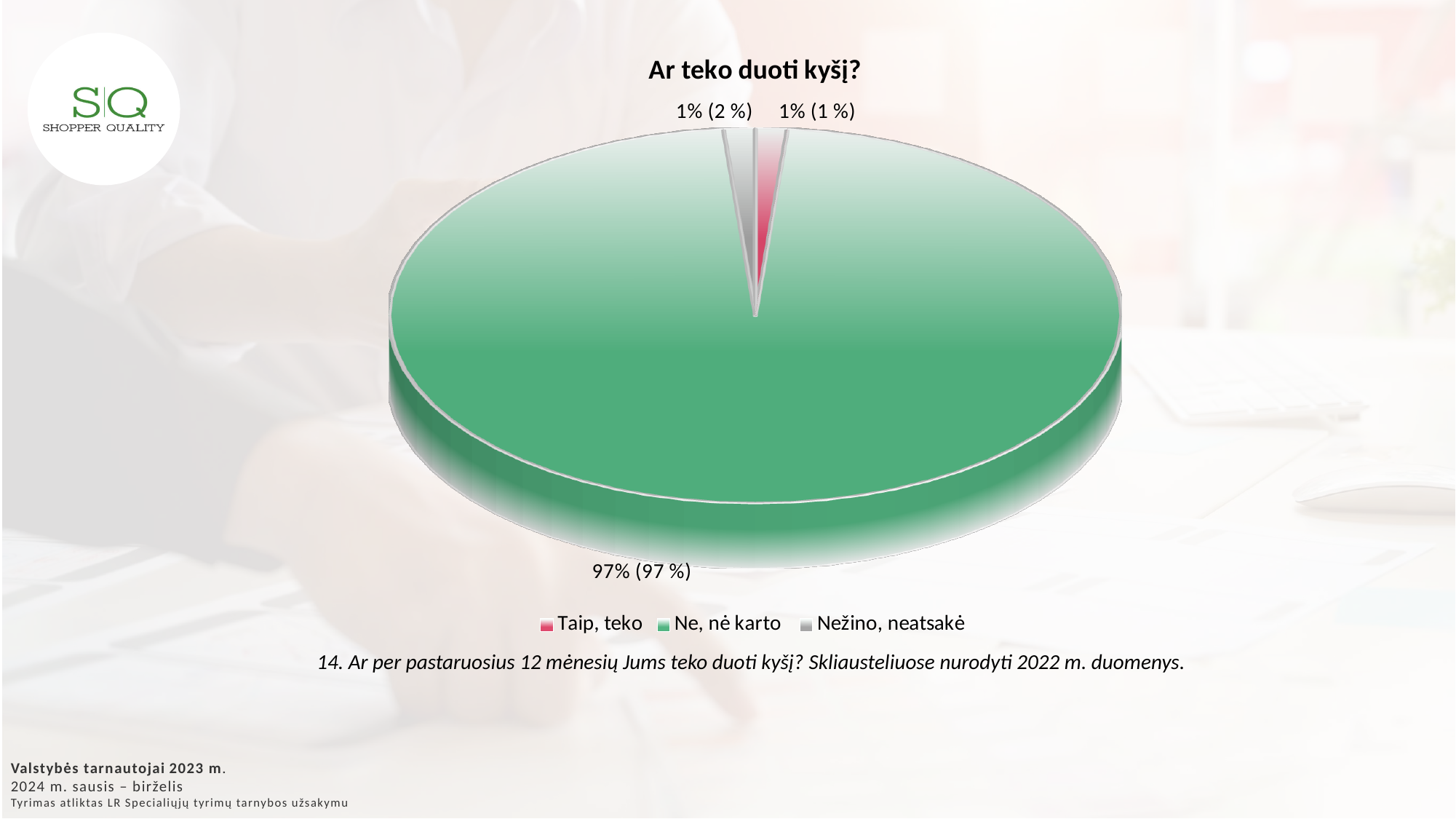
What kind of chart is shown on the slide? pie chart What is the 2023 value shown for "Ne, nė karto"? 97% Which colour represents "Taip, teko" in the legend? red Which is larger, the share for "Ne, nė karto" or the share for "Taip, teko"? Ne, nė karto How many slices does the pie chart have? 3 What is the 2023 value shown for "Taip, teko"? 1% What is the 2023 value shown for "Nežino, neatsakė"? 1% How many entries does the legend list? 3 What is the 2022 value shown in brackets for "Ne, nė karto"? 97 % What share of the pie does "Ne, nė karto" take? 97% Which category has the largest share of the pie? Ne, nė karto What is the title of the chart? Ar teko duoti kyšį?